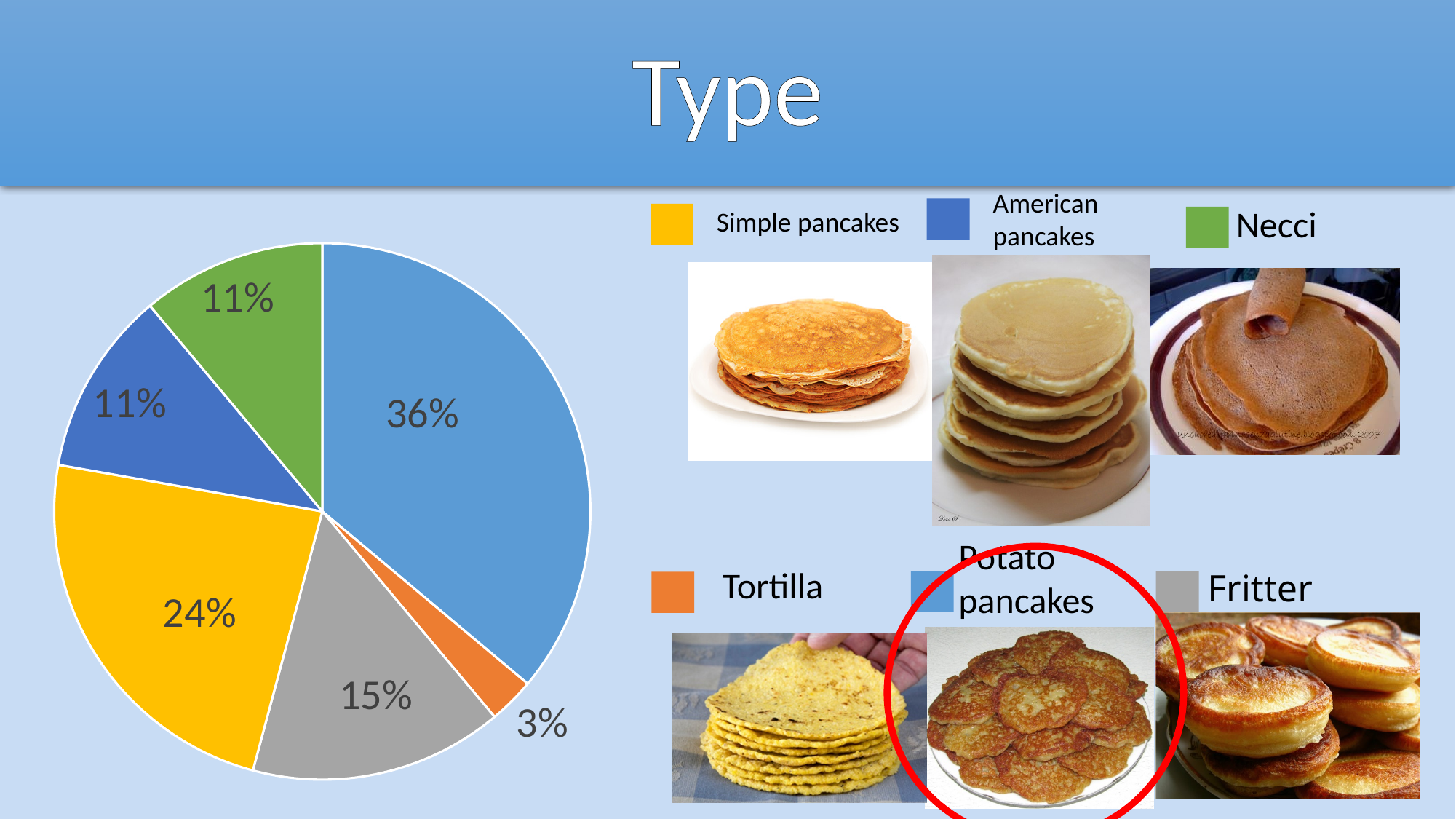
Which is larger, the share for Fritter or the share for Tortilla? Fritter What is the value for Necci? 11% Which category has the smallest slice of the pie? Tortilla What is the value for Simple pancakes? 24% What share of the pie does Potato pancakes have? 36% What is the difference between the Potato pancakes share and the Simple pancakes share? 12% Which category has the largest slice of the pie? Potato pancakes How many slices does the pie chart have? 6 What is the value for Fritter? 15% What is the value for Tortilla? 3% What type of chart is shown on the slide? pie chart Which colour represents Necci in the legend? green